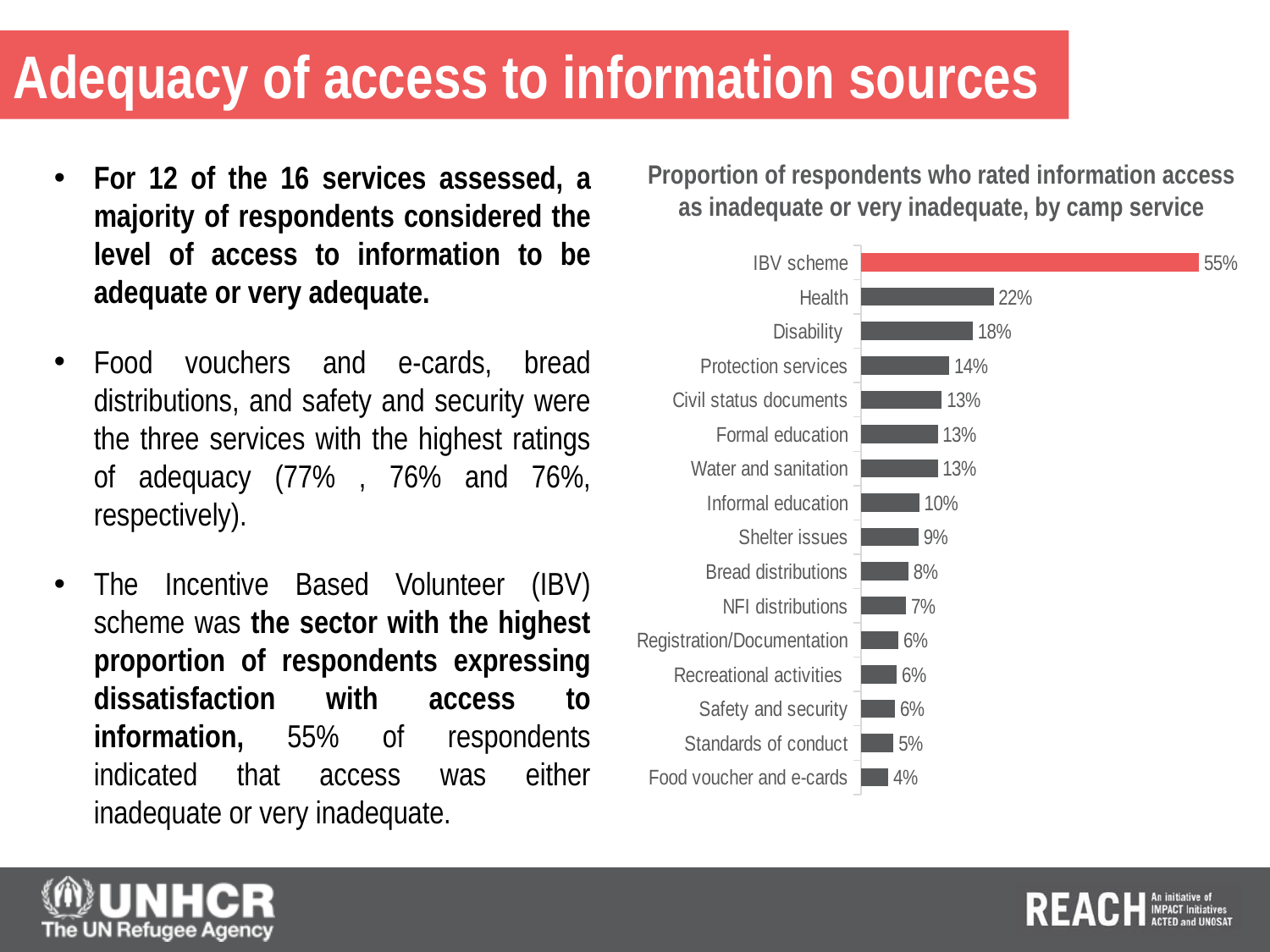
What is the value shown for Health? 22% What is the difference between the values for IBV scheme and Health? 33 percentage points Which camp service has the lowest proportion of respondents rating information access as inadequate or very inadequate? Food voucher and e-cards What is the value shown for Informal education? 10% Which camp service has the highest proportion of respondents rating information access as inadequate or very inadequate? IBV scheme What is the value shown for Food voucher and e-cards? 4% What is the difference between the values for Disability and Bread distributions? 10 percentage points What type of chart is used on the slide? Bar chart What proportion of respondents rated information access as inadequate or very inadequate for the IBV scheme? 55% Which bar in the chart is coloured red rather than grey? IBV scheme Which has a higher value, Protection services or Shelter issues? Protection services How many camp services are shown in the chart? 16